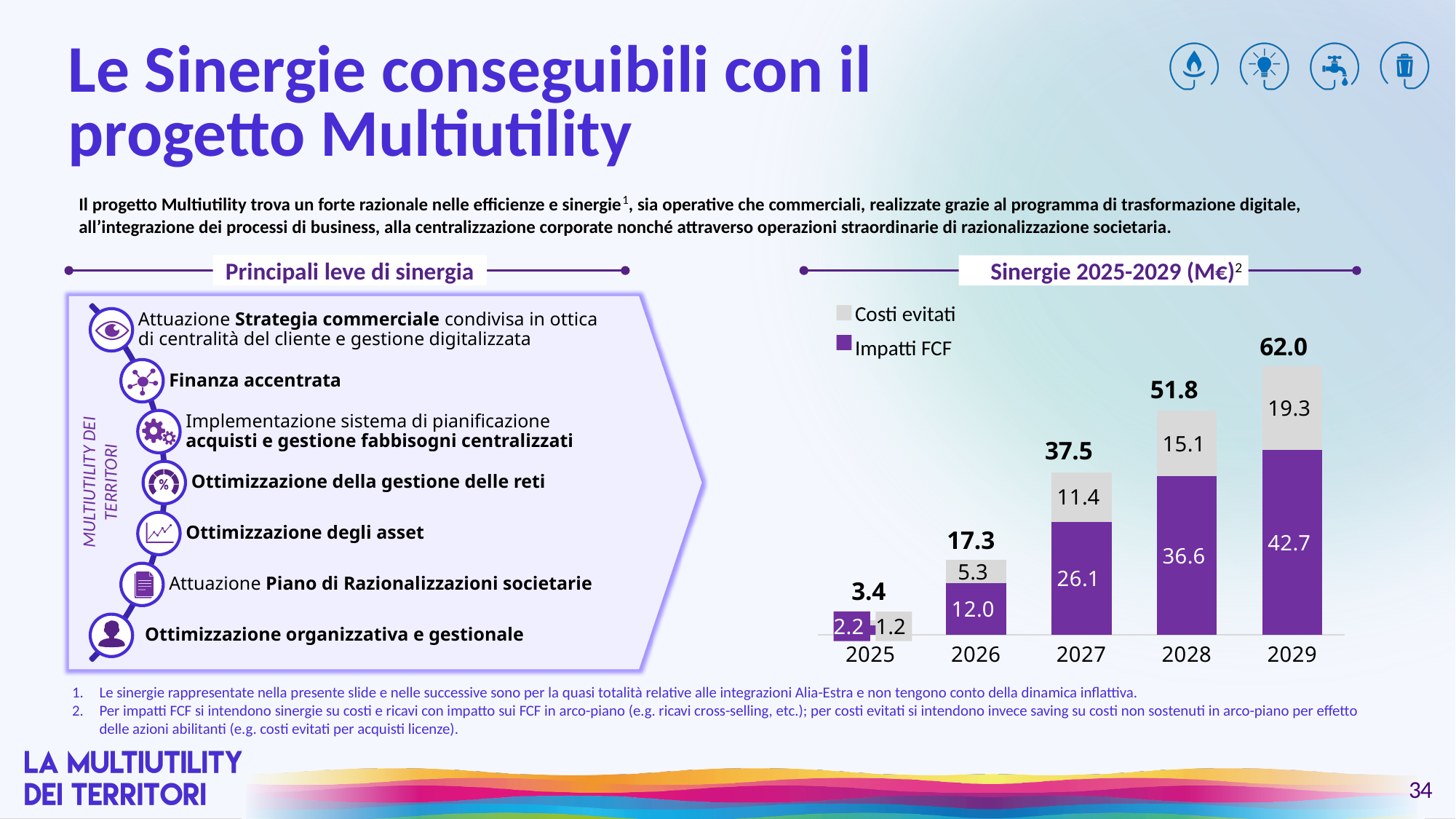
Which is larger in 2026: Impatti FCF or Costi evitati? Impatti FCF What is the title of the chart? Sinergie 2025-2029 (M€) What is the value of Impatti FCF for 2027? 26.1 How many series does the chart legend list? 2 What is the difference between the Impatti FCF values for 2029 and 2028? 6.1 Which year has the highest total synergies? 2029 What is the value of Costi evitati for 2028? 15.1 What is the total of the stacked bar for 2029? 62.0 How many years are shown on the x axis of the chart? 5 What kind of chart is used to show the Sinergie 2025-2029? Stacked bar chart Which year has the lowest total synergies? 2025 Do the total synergies rise or fall from 2025 to 2029? Rise